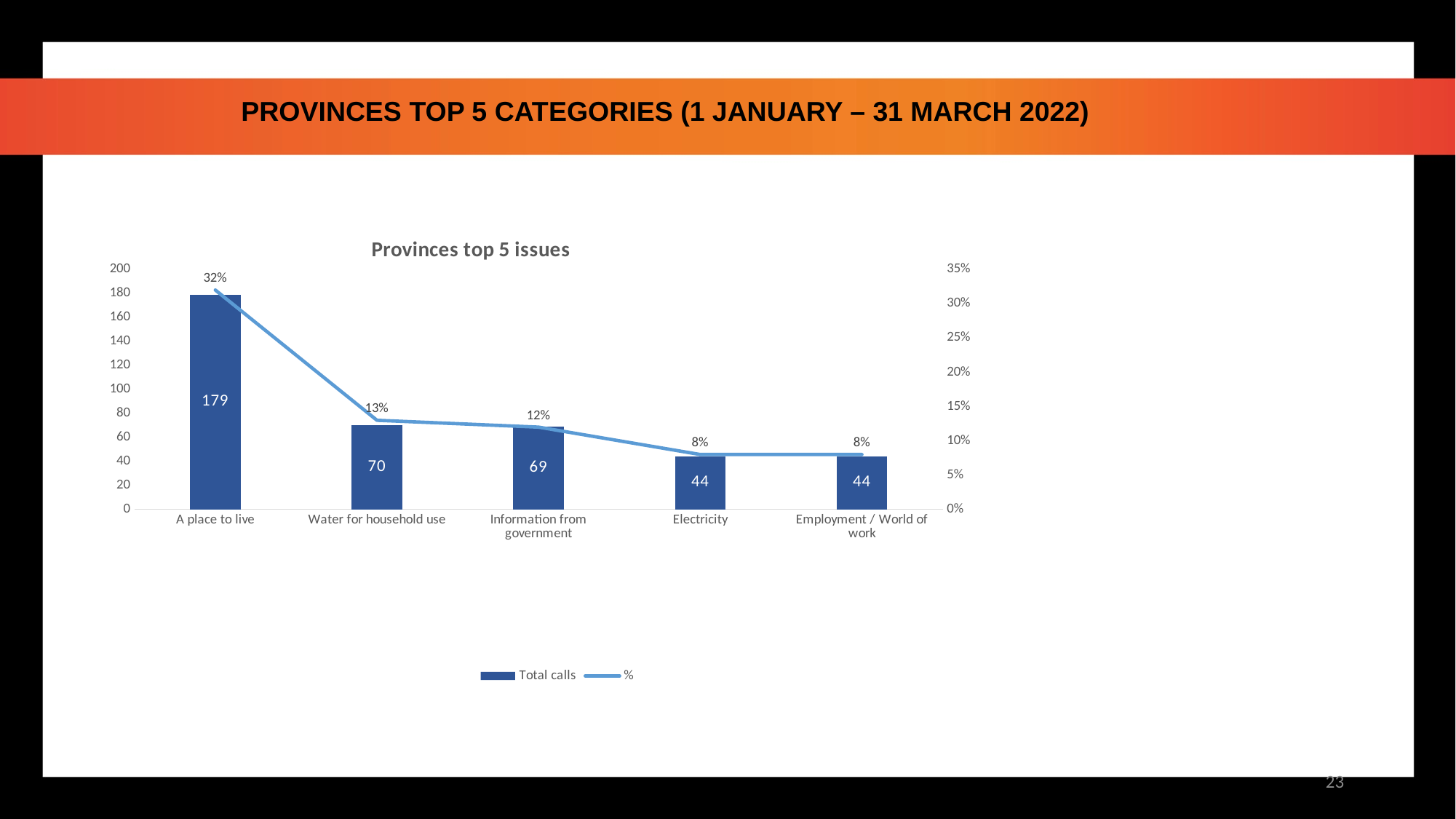
How many series does the legend list? 2 Which has more total calls, Water for household use or Electricity? Water for household use What is the title of the chart? Provinces top 5 issues Do the total calls values rise or fall from left to right along the x axis? fall What percentage is shown for Electricity? 8% What is the difference in total calls between Information from government and Electricity? 25 Which category has the highest total calls? A place to live What is the total calls value for A place to live? 179 How many categories are shown on the x axis? 5 What is the total calls value for Water for household use? 70 What percentage is shown for Information from government? 12% What is the difference in total calls between A place to live and Water for household use? 109